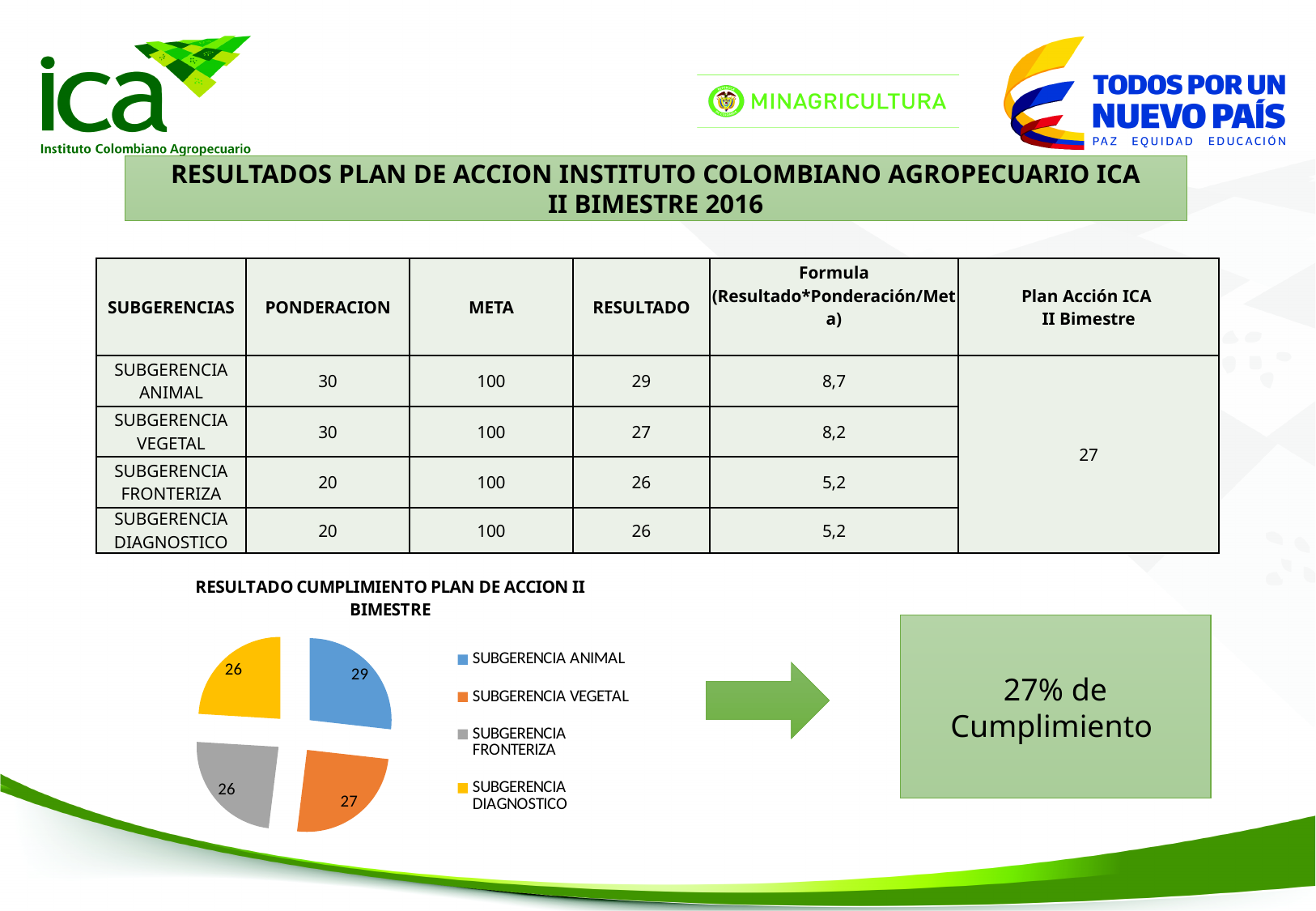
Which two categories share the smallest value in the pie chart? SUBGERENCIA FRONTERIZA and SUBGERENCIA DIAGNOSTICO What is the difference between the values for SUBGERENCIA ANIMAL and SUBGERENCIA FRONTERIZA in the pie chart? 3 What is the value for SUBGERENCIA VEGETAL in the pie chart? 27 What is the value for SUBGERENCIA DIAGNOSTICO in the pie chart? 26 What type of chart is shown on the slide? pie chart What is the title of the pie chart? RESULTADO CUMPLIMIENTO PLAN DE ACCION II BIMESTRE What is the difference between the values for SUBGERENCIA ANIMAL and SUBGERENCIA VEGETAL in the pie chart? 2 Which is larger in the pie chart, SUBGERENCIA VEGETAL or SUBGERENCIA DIAGNOSTICO? SUBGERENCIA VEGETAL Which category has the largest slice in the pie chart? SUBGERENCIA ANIMAL What is the value for SUBGERENCIA ANIMAL in the pie chart? 29 How many slices does the pie chart have? 4 What is the value for SUBGERENCIA FRONTERIZA in the pie chart? 26